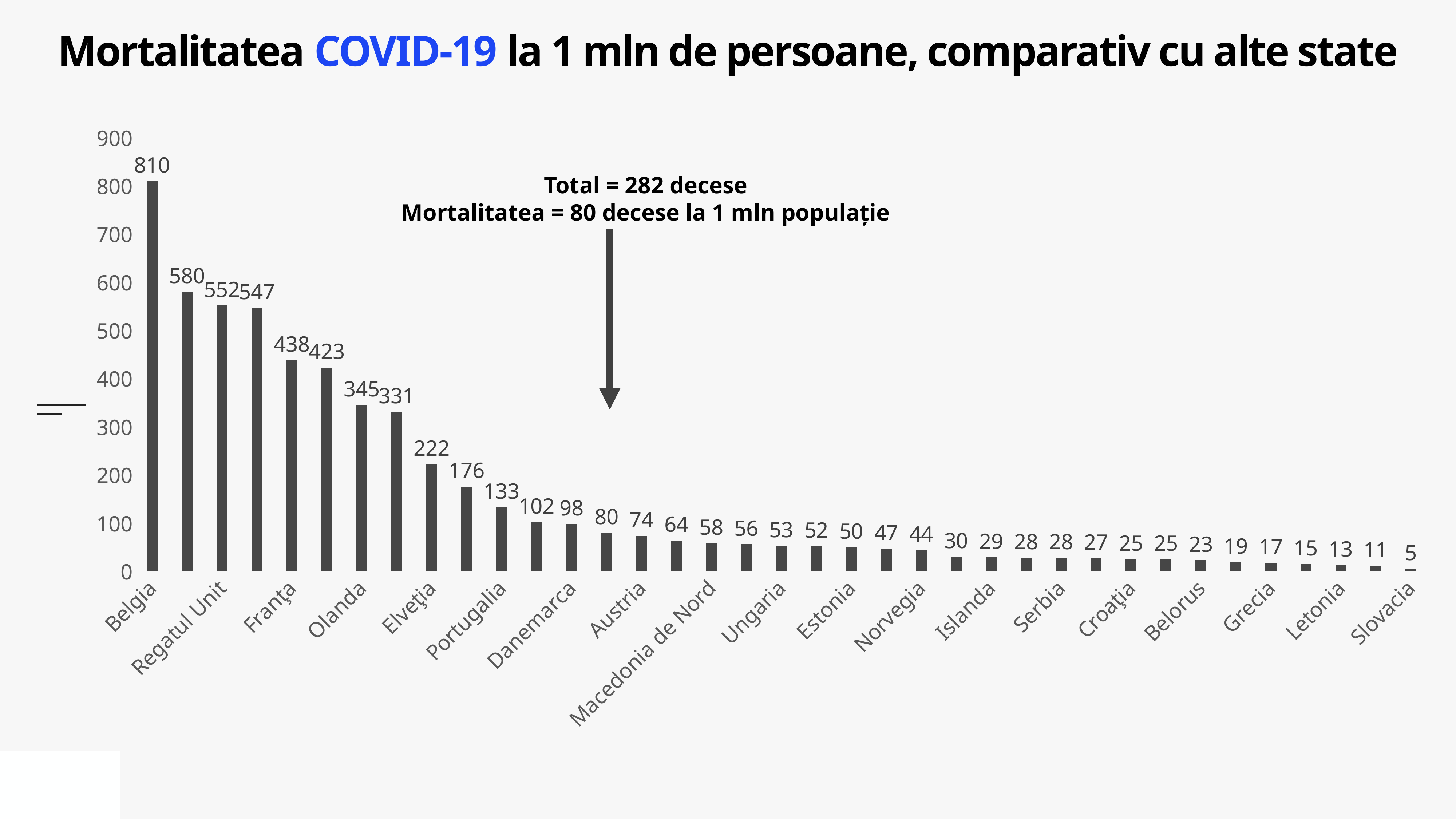
What is the difference between the values for Belgia and Regatul Unit? 258 What is the value for Danemarca? 98 Do the values rise or fall from left to right along the x axis? fall What is the value for Belgia? 810 What is the value for Slovacia? 5 Which country has the highest COVID-19 mortality per 1 mln in the chart? Belgia According to the annotation on the chart, what is the total number of deaths (Total = ... decese)? 282 Which country has the lowest value in the chart? Slovacia What kind of chart is shown on the slide? bar chart Which has a larger value, Franța or Olanda? Franța What is the value for Regatul Unit? 552 Is the value for Elveția greater or less than 200? greater